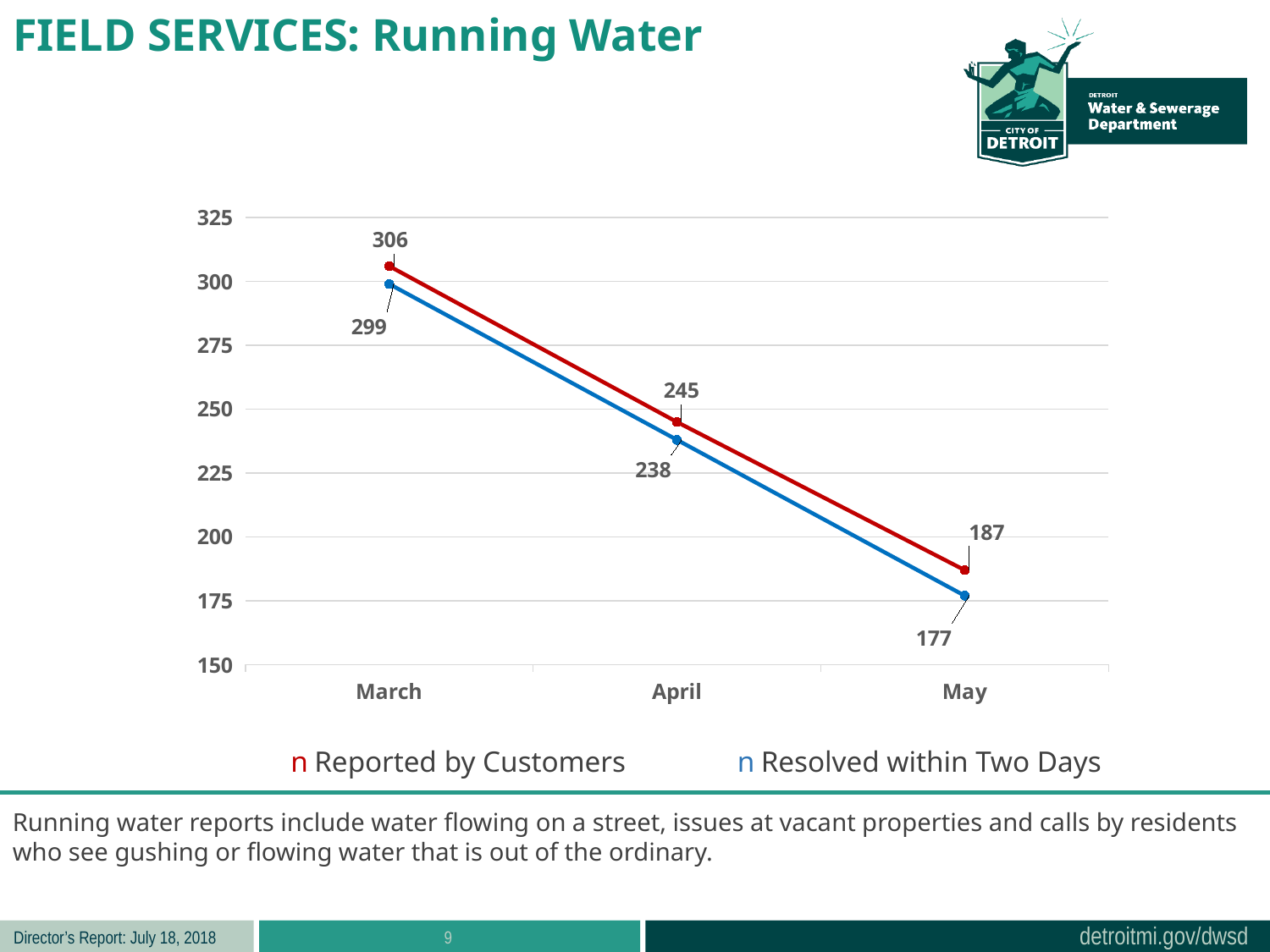
How much did the number reported by customers fall from March to May? 119 How many running water reports were reported by customers in March? 306 What is the difference between reports reported by customers and those resolved within two days in April? 7 What is the value for Resolved within Two Days in April? 238 What kind of chart is shown on the slide? Line chart In which month was the number resolved within two days lowest? May In which month was the number reported by customers highest? March Which is larger in May: Reported by Customers or Resolved within Two Days? Reported by Customers Do the values for Reported by Customers rise or fall from March to May? Fall How many running water reports were resolved within two days in May? 177 How many months are shown on the x axis? 3 How many series does the legend list? 2